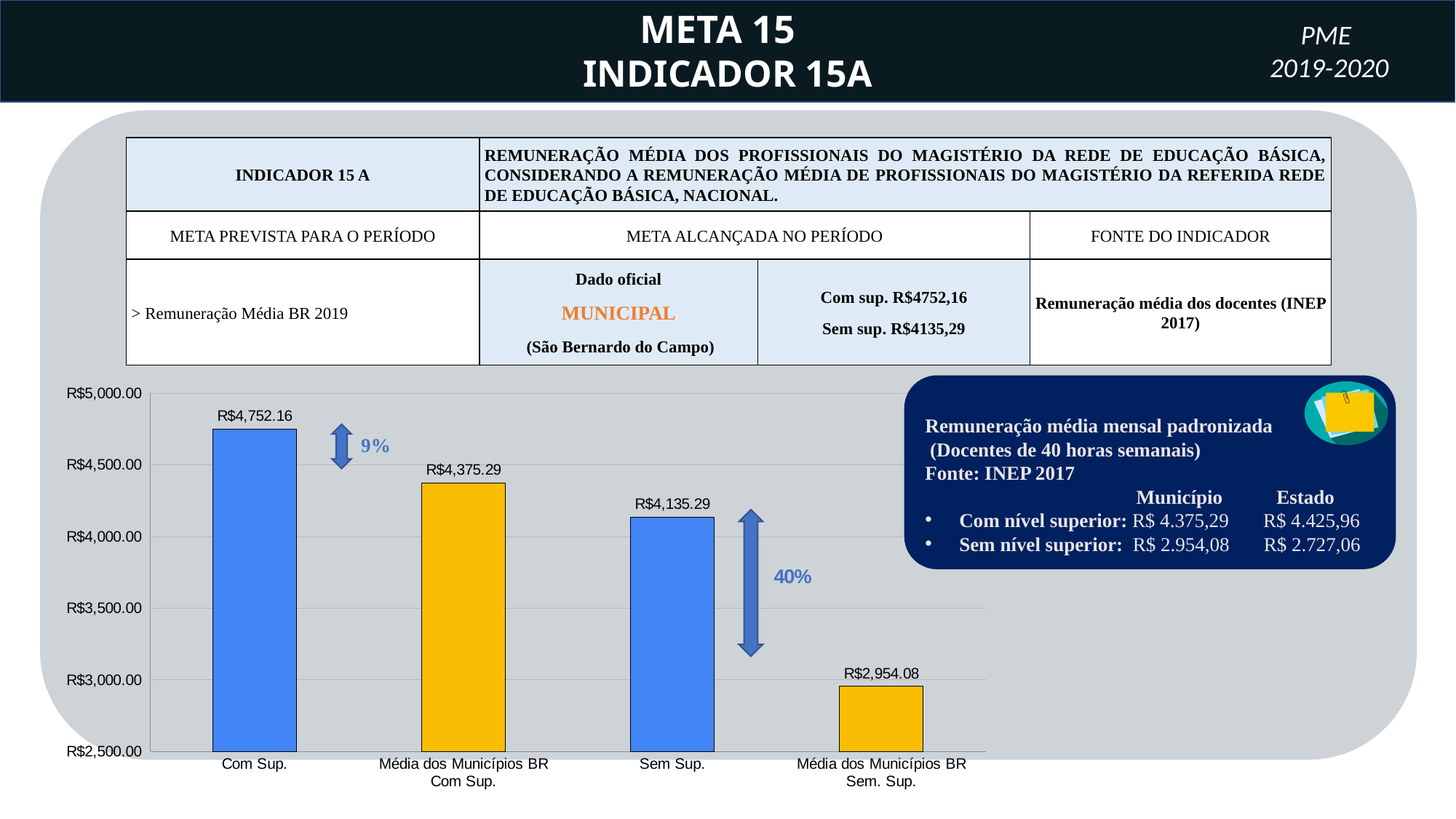
Which category has the lowest value in the chart? Média dos Municípios BR Sem. Sup. What is the value of the Com Sup. bar? R$4,752.16 What is the difference between the Sem Sup. bar and the Média dos Municípios BR Sem. Sup. bar? R$1,181.21 Is the value for Média dos Municípios BR Sem. Sup. greater or less than R$3,000.00? less How many bars are shown in the chart? 4 What is the value of the Sem Sup. bar? R$4,135.29 What is the difference between the Com Sup. bar and the Média dos Municípios BR Com Sup. bar? R$376.87 What type of chart is shown on the slide? bar chart Which category has the highest value in the chart? Com Sup. What is the value of the Média dos Municípios BR Com Sup. bar? R$4,375.29 Which is larger, the Sem Sup. bar or the Média dos Municípios BR Com Sup. bar? Média dos Municípios BR Com Sup. What is the value of the Média dos Municípios BR Sem. Sup. bar? R$2,954.08